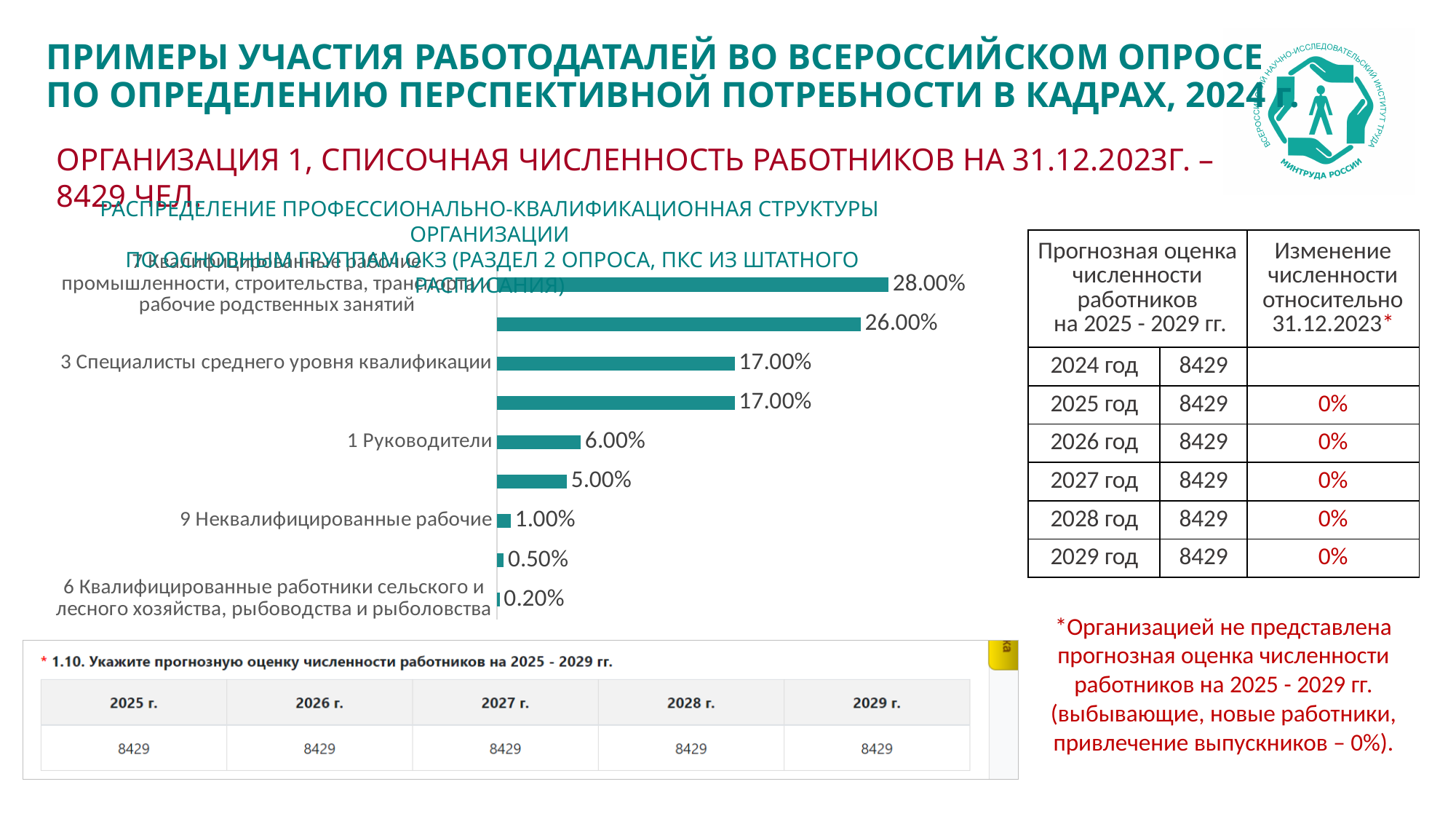
Which is larger: the value for "3 Специалисты среднего уровня квалификации" or for "1 Руководители"? 3 Специалисты среднего уровня квалификации How many bars are plotted on the chart? 9 What is the value for "9 Неквалифицированные рабочие"? 1.00% What is the value for "1 Руководители"? 6.00% Which category has the lowest value on the bar chart? 6 Квалифицированные работники сельского и лесного хозяйства, рыбоводства и рыболовства What is the value for "3 Специалисты среднего уровня квалификации"? 17.00% What is the difference between the values for "1 Руководители" and "9 Неквалифицированные рабочие"? 5.00% What is the value for "6 Квалифицированные работники сельского и лесного хозяйства, рыбоводства и рыболовства"? 0.20% What colour are the bars on the chart? Teal What is the largest value shown on the bar chart? 28.00% What kind of chart is shown on the slide? Bar chart